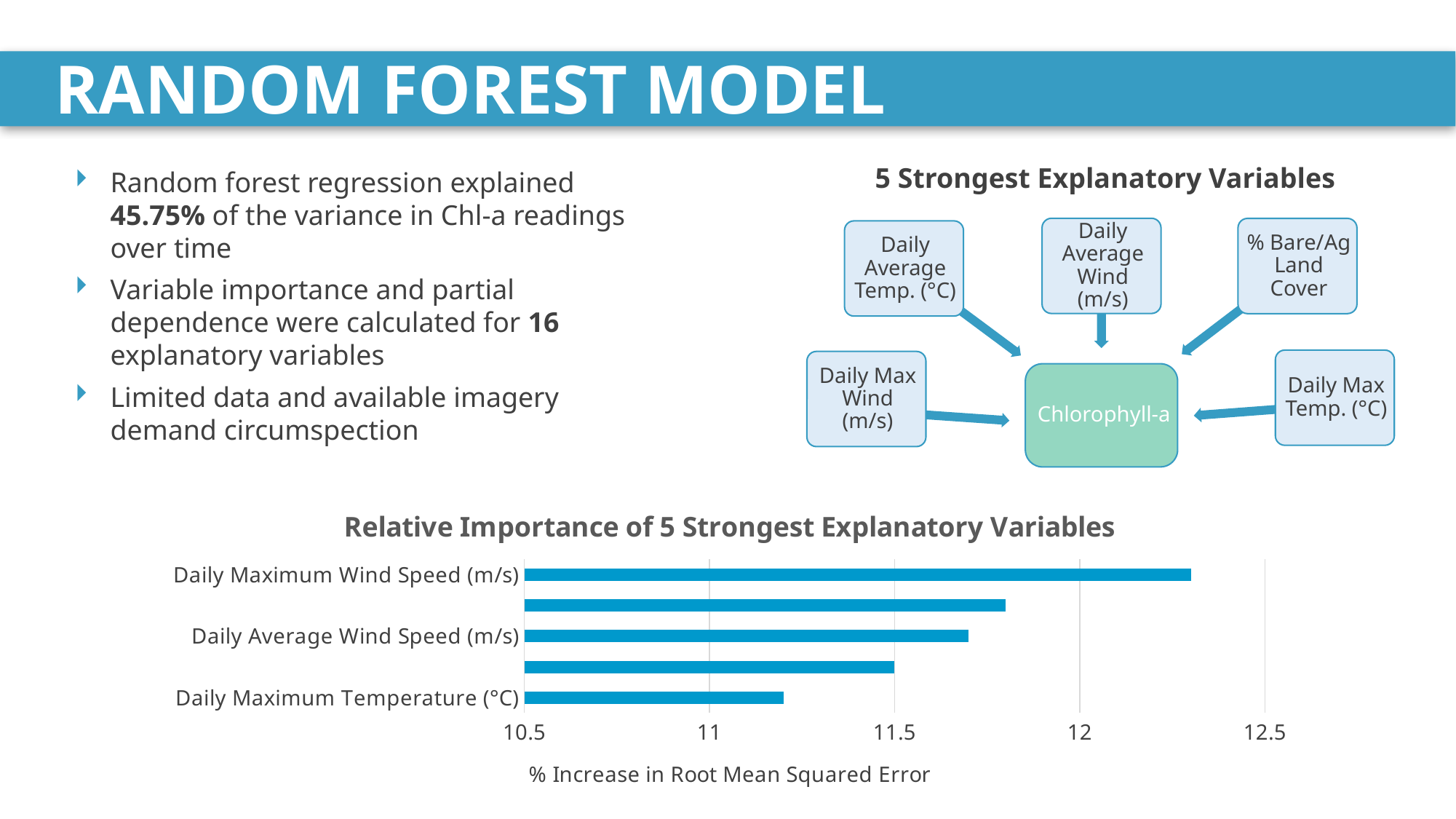
Which labelled variable has the lowest % increase in root mean squared error in the bar chart? Daily Maximum Temperature (°C) Is the value for Daily Maximum Temperature (°C) greater or less than 11.5? less What kind of chart is shown at the bottom of the slide? bar chart Is the value for Daily Maximum Wind Speed (m/s) greater or less than 12? greater What is the title of the bar chart? Relative Importance of 5 Strongest Explanatory Variables Which is larger in the bar chart: the value for Daily Average Wind Speed (m/s) or Daily Maximum Temperature (°C)? Daily Average Wind Speed (m/s) Which variable has the highest % increase in root mean squared error in the bar chart? Daily Maximum Wind Speed (m/s) Which is larger in the bar chart: the value for Daily Maximum Wind Speed (m/s) or Daily Maximum Temperature (°C)? Daily Maximum Wind Speed (m/s) What is the x-axis label of the bar chart? % Increase in Root Mean Squared Error Is the value for Daily Average Wind Speed (m/s) greater or less than 11.5? greater How many bars are plotted in the 'Relative Importance of 5 Strongest Explanatory Variables' chart? 5